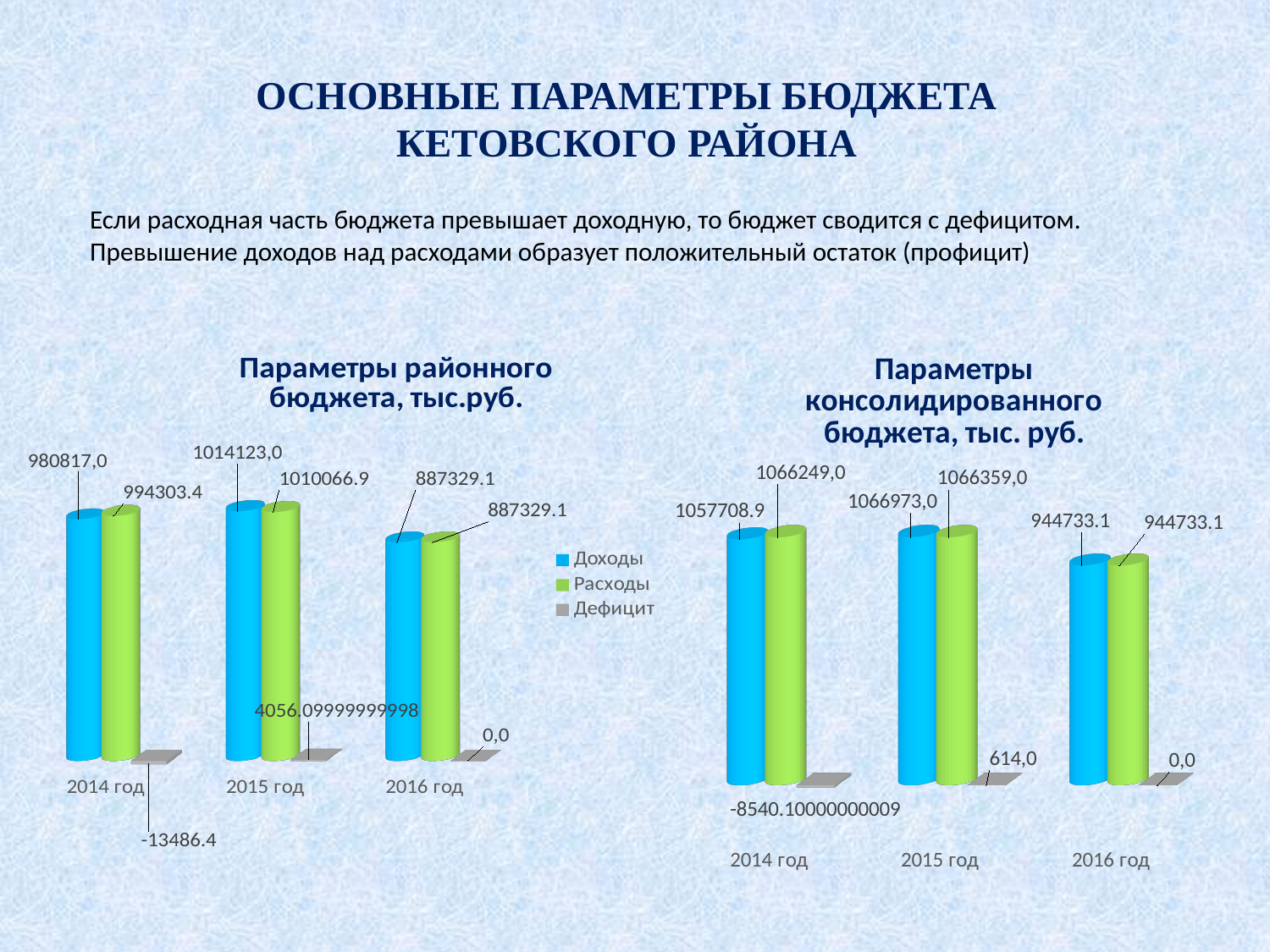
In the chart 'Параметры консолидированного бюджета, тыс. руб.', what is the value of Дефицит for 2015 год? 614,0 In the chart 'Параметры районного бюджета, тыс.руб.', which year has the highest Доходы value? 2015 год In the chart 'Параметры консолидированного бюджета, тыс. руб.', what is the value of Расходы for 2016 год? 944733.1 In the chart 'Параметры районного бюджета, тыс.руб.', what is the value of Доходы for 2014 год? 980817,0 In the chart 'Параметры районного бюджета, тыс.руб.', how many series does the legend list? 3 In the chart 'Параметры консолидированного бюджета, тыс. руб.', what is the value of Доходы for 2014 год? 1057708.9 In the chart 'Параметры районного бюджета, тыс.руб.', which year has the lowest Расходы value? 2016 год In the chart 'Параметры районного бюджета, тыс.руб.', what is the value of Дефицит for 2014 год? -13486.4 In the chart 'Параметры районного бюджета, тыс.руб.', what is the value of Расходы for 2015 год? 1010066.9 What kind of chart is 'Параметры консолидированного бюджета, тыс. руб.'? Bar chart How many year categories are shown in the chart 'Параметры районного бюджета, тыс.руб.'? 3 In the chart 'Параметры консолидированного бюджета, тыс. руб.', which year has the lowest Доходы value? 2016 год